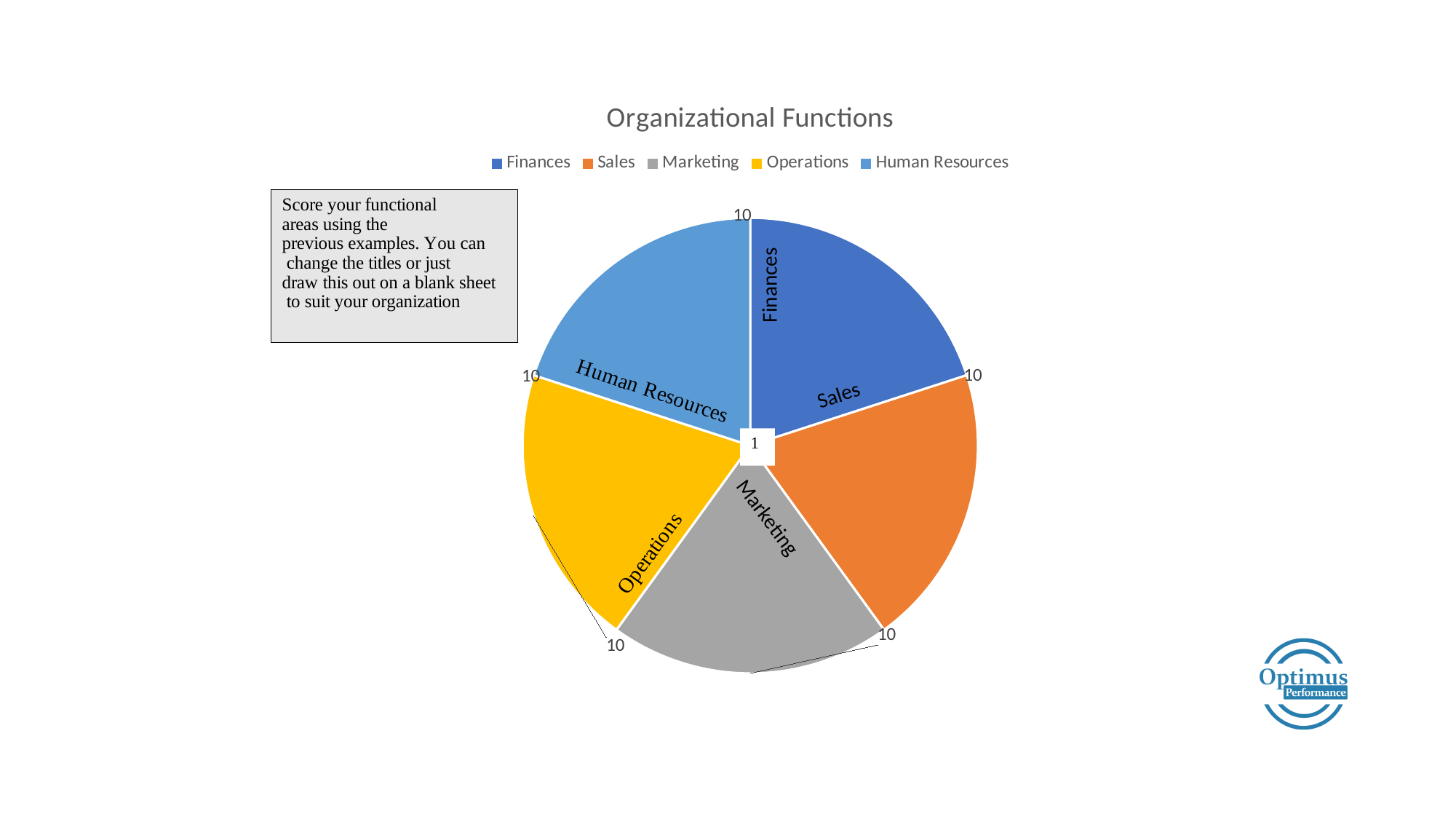
How many entries does the chart legend list? 5 What is the title of the chart? Organizational Functions How many slices does the pie chart have? 5 What share of the pie does the Operations slice represent? 20% What kind of chart is shown on the slide? pie chart What is the difference between the values for Finances and Marketing? 0 Which colour is used for the Operations slice in the legend? yellow